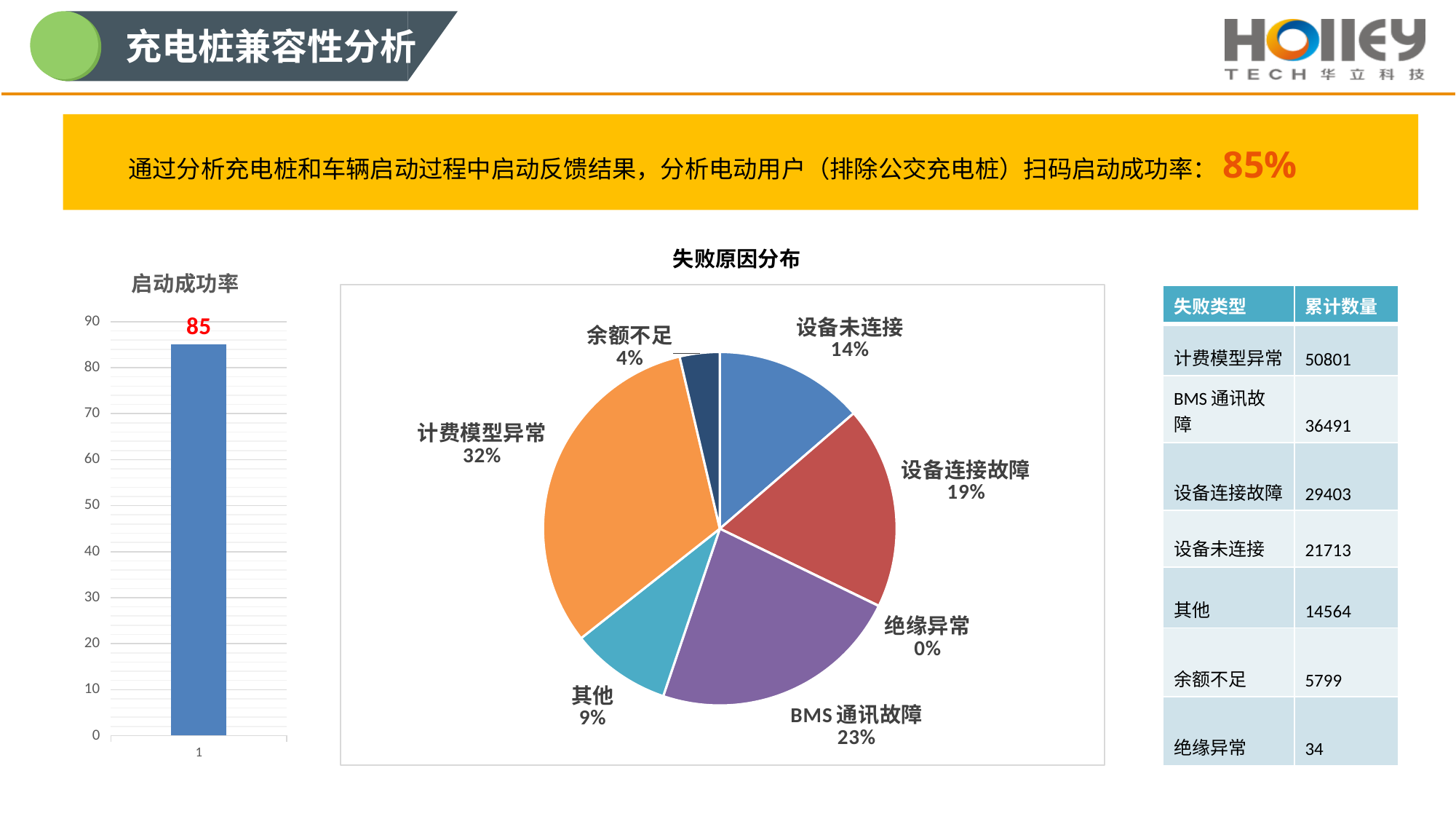
What kind of chart is the chart titled 失败原因分布? pie chart In the pie chart titled 失败原因分布, which category has the largest slice? 计费模型异常 In the bar chart titled 启动成功率, what value is shown on the bar? 85 How many slices are labelled in the pie chart titled 失败原因分布? 7 In the pie chart titled 失败原因分布, what share does BMS 通讯故障 have? 23% In the pie chart titled 失败原因分布, what share does 计费模型异常 have? 32% In the pie chart titled 失败原因分布, which category has the smallest slice? 绝缘异常 In the bar chart titled 启动成功率, is the value of the bar greater or less than 80? greater What kind of chart is the chart titled 启动成功率? bar chart How many bars are plotted in the chart titled 启动成功率? 1 In the pie chart titled 失败原因分布, which is larger: 其他 or 余额不足? 其他 In the pie chart titled 失败原因分布, what is the difference in percentage points between 设备连接故障 and 设备未连接? 5%